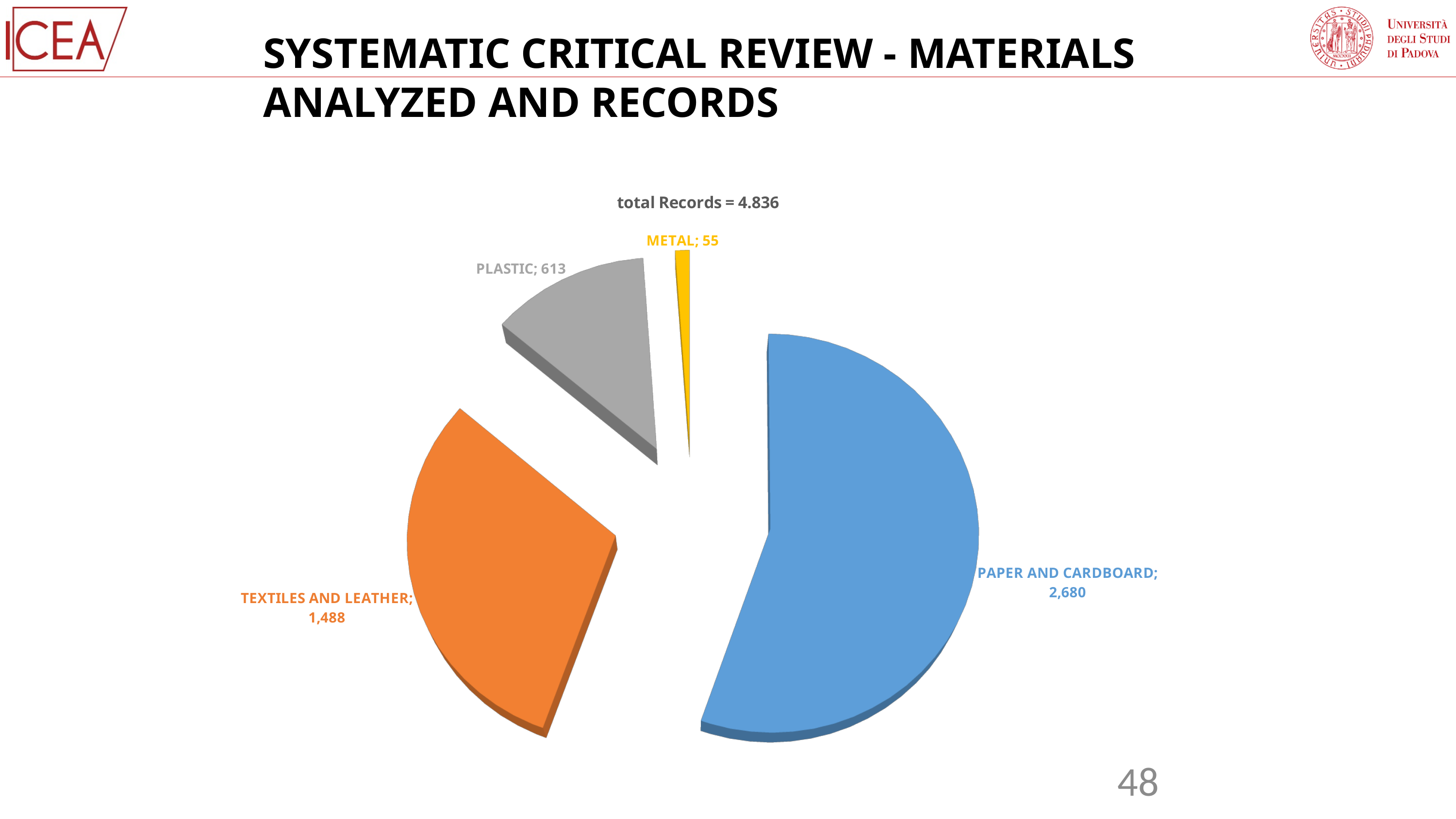
What total number of records is stated in the chart title? 4.836 What is the difference in records between PAPER AND CARDBOARD and TEXTILES AND LEATHER? 1,192 What colour is the PAPER AND CARDBOARD slice? blue Which material has the largest number of records? PAPER AND CARDBOARD How many records are shown for TEXTILES AND LEATHER? 1,488 Which material has the smallest number of records? METAL How many records are shown for PLASTIC? 613 How many records are shown for PAPER AND CARDBOARD? 2,680 What kind of chart is shown on the slide? pie chart How many slices does the pie chart have? 4 How many records are shown for METAL? 55 Which has more records, PLASTIC or METAL? PLASTIC